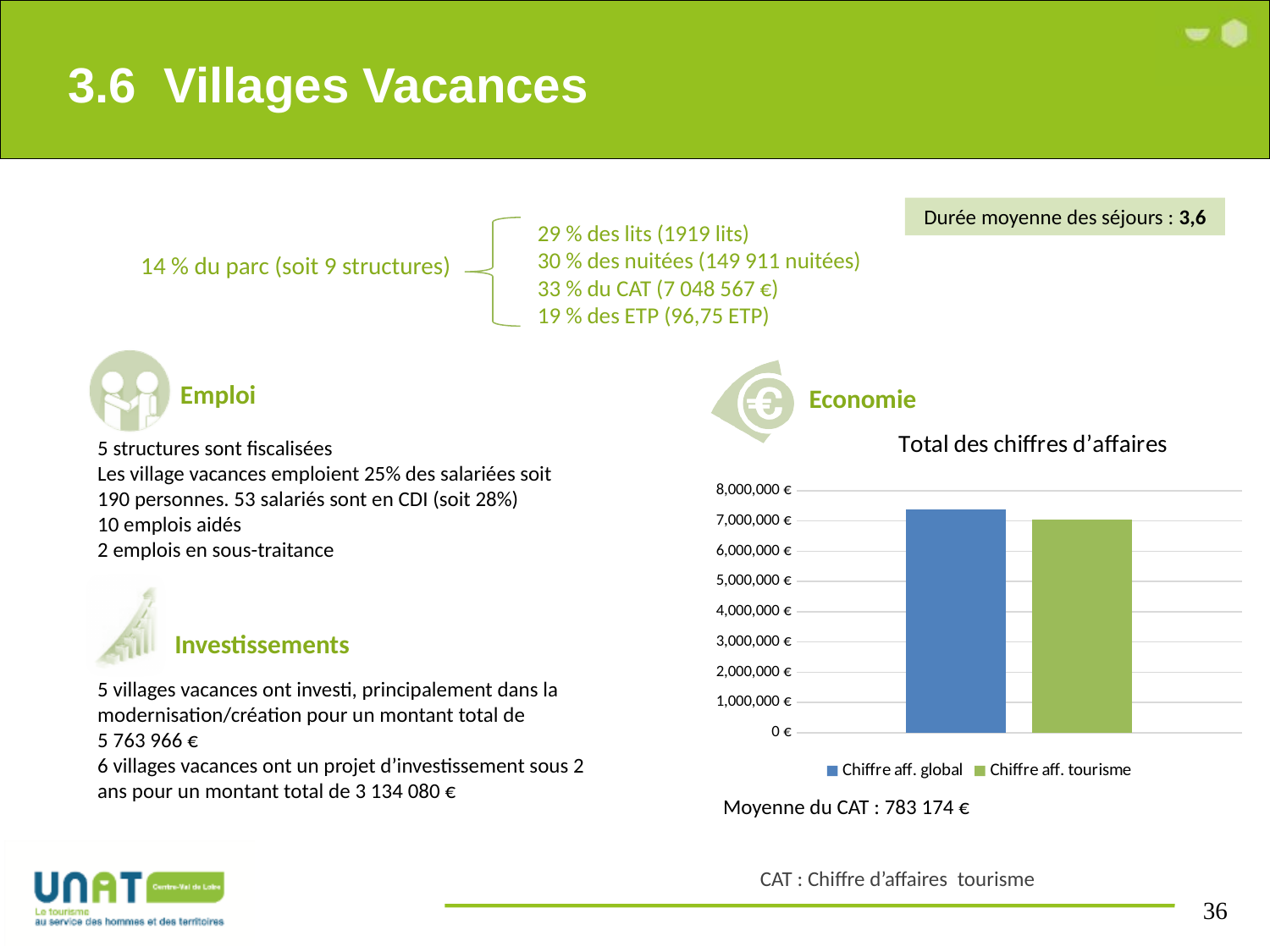
How many bars are plotted in the 'Total des chiffres d'affaires' chart? 2 In the 'Total des chiffres d'affaires' chart, is the value for Chiffre aff. global greater or less than 7,000,000 €? greater How many series does the legend of the 'Total des chiffres d'affaires' chart list? 2 In the 'Total des chiffres d'affaires' chart, is the value for Chiffre aff. tourisme greater or less than 6,000,000 €? greater In the 'Total des chiffres d'affaires' chart, which series has the lowest bar? Chiffre aff. tourisme In the 'Total des chiffres d'affaires' chart, is the value for Chiffre aff. tourisme greater or less than 8,000,000 €? less In the 'Total des chiffres d'affaires' chart, what colour is the bar for Chiffre aff. tourisme? green What type of chart is shown under the 'Economie' heading? bar chart In the 'Total des chiffres d'affaires' chart, which series has the highest bar? Chiffre aff. global In the 'Total des chiffres d'affaires' chart, which is larger: Chiffre aff. global or Chiffre aff. tourisme? Chiffre aff. global What is the title of the chart on the slide? Total des chiffres d'affaires